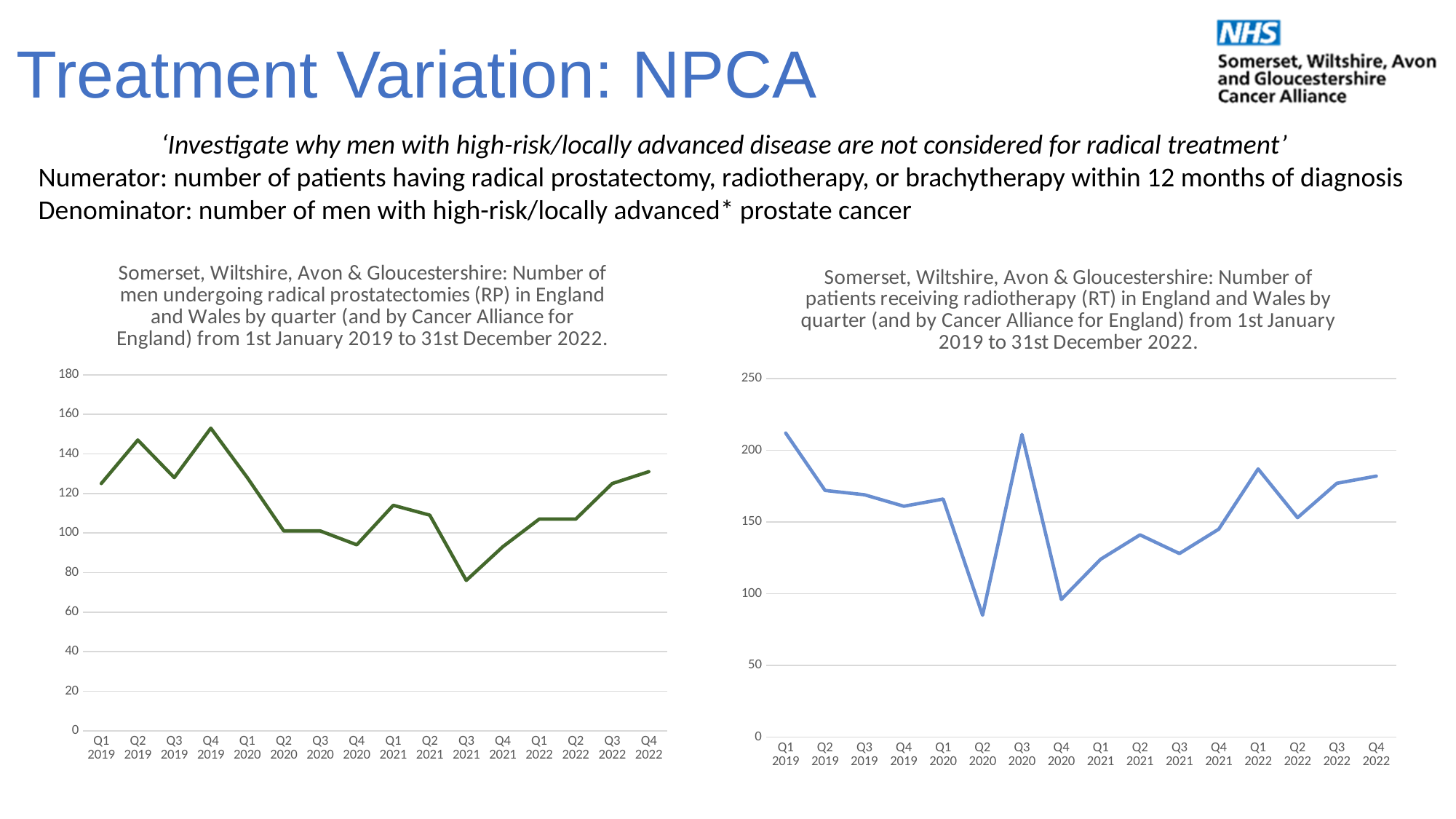
In the left chart (radical prostatectomies), which is larger, the value for Q2 2019 or the value for Q3 2019? Q2 2019 In the left chart (radical prostatectomies), is the value for Q4 2019 greater or less than 140? greater In the left chart (radical prostatectomies), how many quarters are plotted along the x axis? 16 What type of chart is the left chart about radical prostatectomies (RP)? line chart In the left chart (radical prostatectomies), which quarter has the highest value? Q4 2019 In the right chart (radiotherapy), which is larger, the value for Q1 2022 or the value for Q2 2022? Q1 2022 In the left chart (radical prostatectomies), which quarter has the lowest value? Q3 2021 In the right chart (radiotherapy), is the value for Q1 2022 greater or less than 150? greater In the right chart (radiotherapy), which quarter has the lowest value? Q2 2020 In the right chart (radiotherapy), how many quarters are plotted along the x axis? 16 In the left chart (radical prostatectomies), is the value for Q3 2021 greater or less than 80? less What type of chart is the right chart about radiotherapy (RT)? line chart